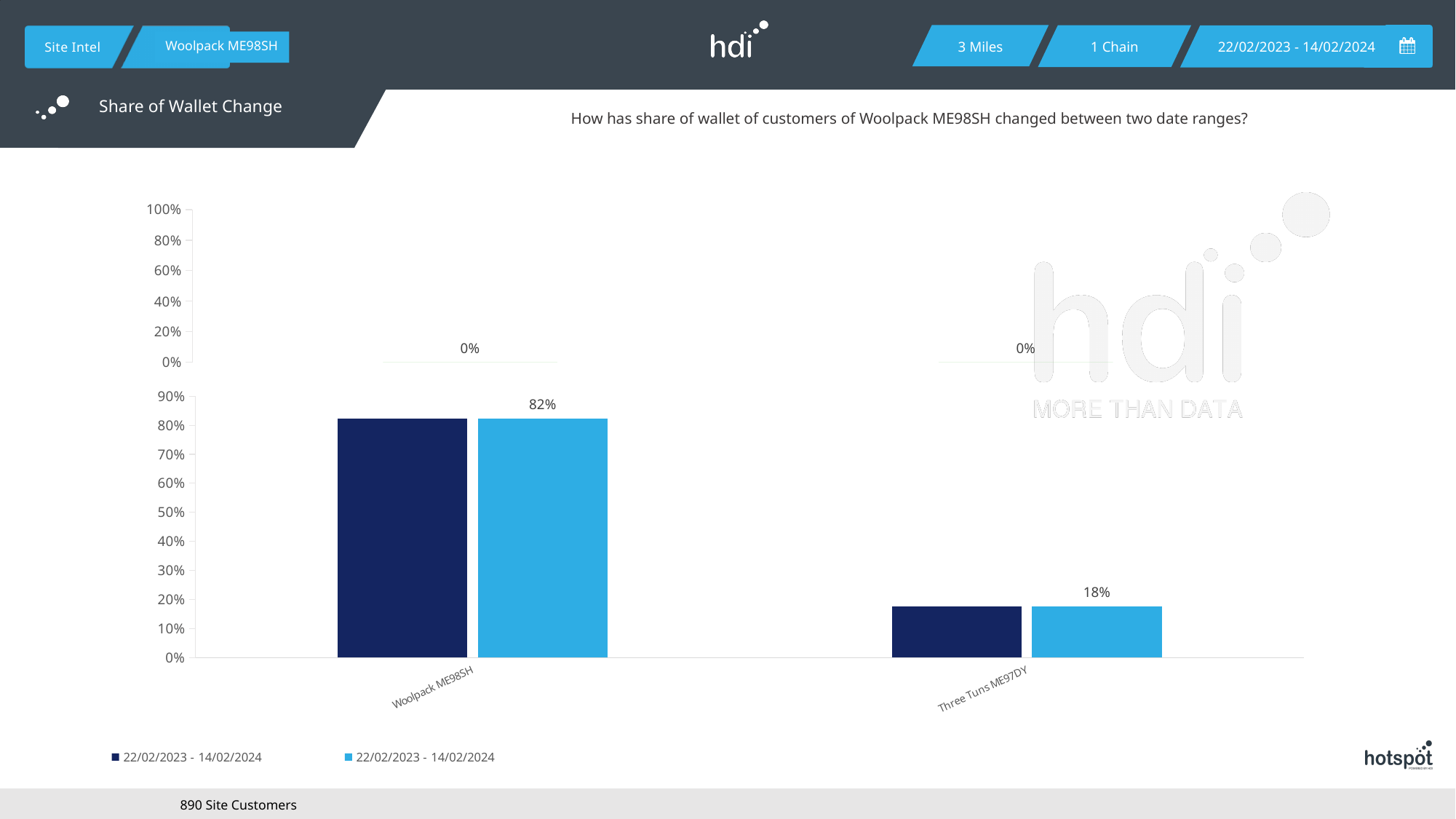
In the upper chart, what change value is labelled above Woolpack ME98SH? 0% What is the share of wallet value labelled on the light blue bar for Three Tuns ME97DY in the lower chart? 18% What kind of chart is shown on the slide? bar chart What is the difference between the labelled light blue values for Woolpack ME98SH and Three Tuns ME97DY in the lower chart? 64 percentage points Is the dark blue bar for Woolpack ME98SH in the lower chart greater or less than 50%? greater Is the dark blue bar for Three Tuns ME97DY in the lower chart greater or less than 30%? less What is the share of wallet value labelled on the light blue bar for Woolpack ME98SH in the lower chart? 82% How many series does the legend list? 2 How many categories are shown on the x axis of the lower chart? 2 In the lower chart, which has the larger share of wallet: Woolpack ME98SH or Three Tuns ME97DY? Woolpack ME98SH Which category has the lowest share of wallet in the lower chart? Three Tuns ME97DY Which category has the highest share of wallet in the lower chart? Woolpack ME98SH